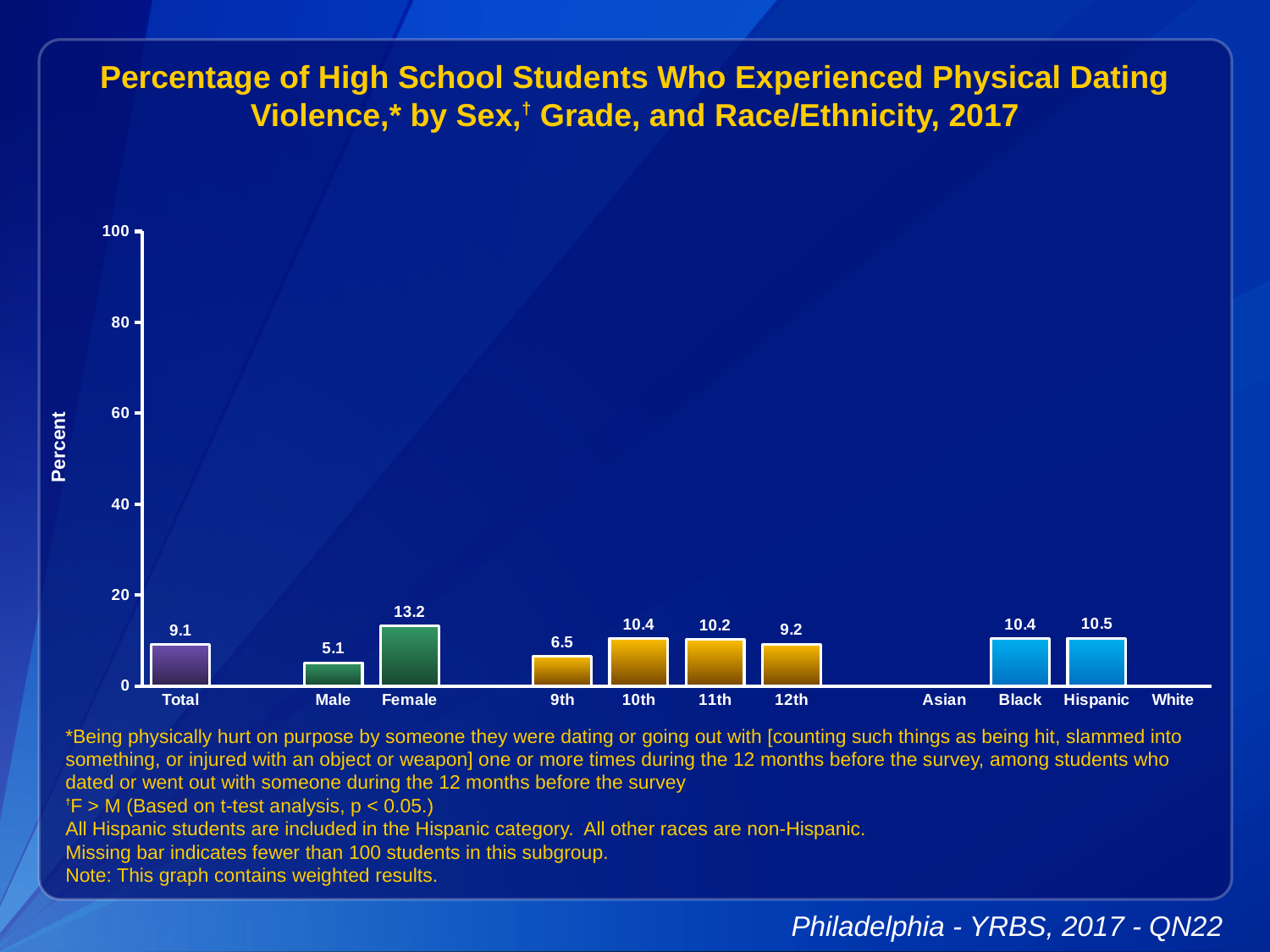
What is the value for Total? 9.1 Which is larger, the value for 10th grade or the value for 12th grade? 10th Is the value for Female greater or less than 20? less What kind of chart is this? bar chart What is the value for 9th grade? 6.5 What is the value for Hispanic? 10.5 What is the difference between the Female and Male values? 8.1 Which category has the highest value? Female What is the value for Female? 13.2 Which category has the lowest value among the bars shown? Male How many categories have no bar shown? 2 What is the label on the y axis? Percent